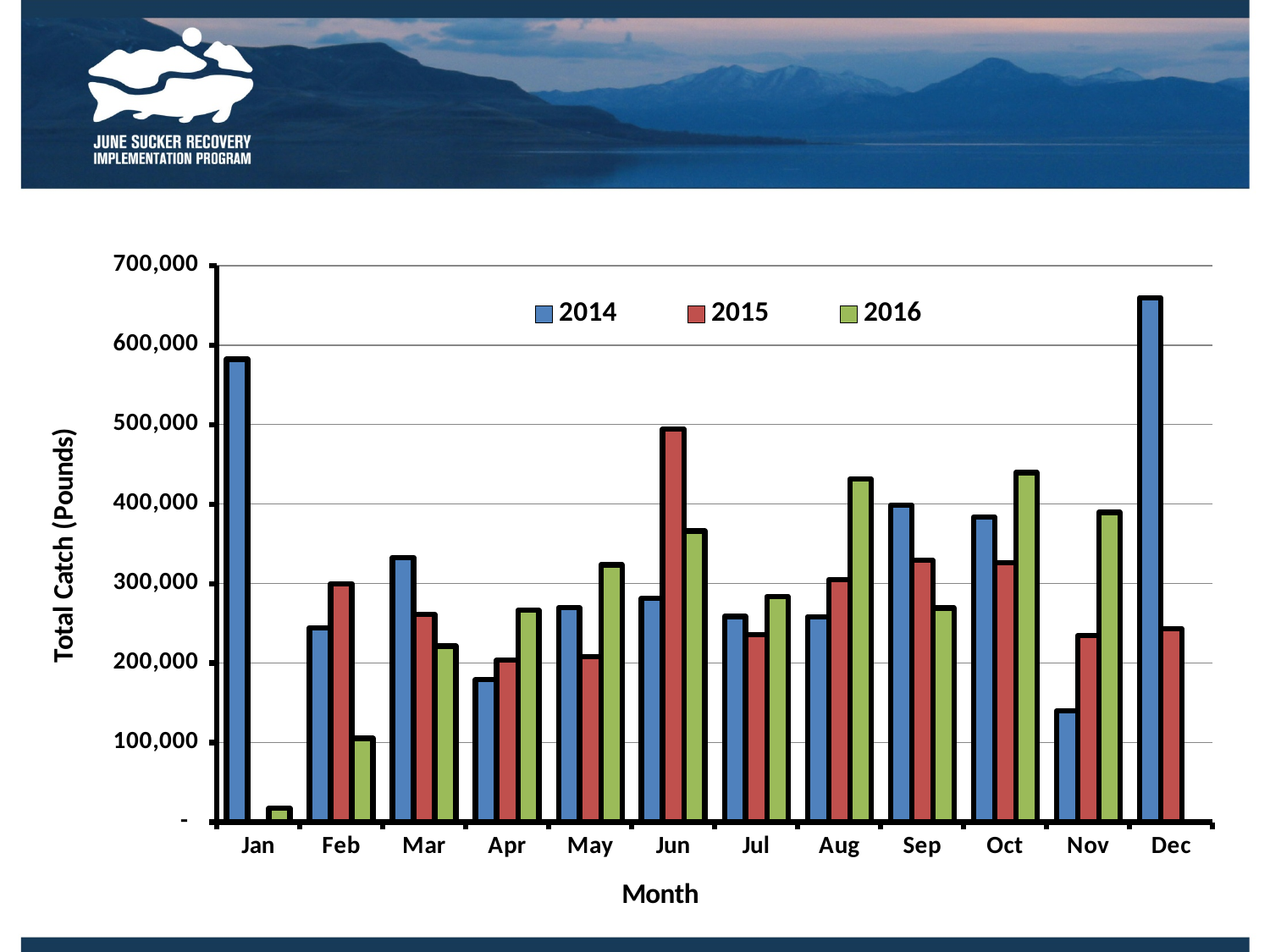
Is the 2016 total catch for Feb greater or less than 200,000? less How many series does the legend list? 3 In which month is the 2014 total catch highest? Dec In Nov, which year has the larger total catch, 2014 or 2016? 2016 Is the 2014 total catch for Jan greater or less than 500,000? greater How many months are shown along the x axis? 12 In which month is the 2015 total catch highest? Jun What is the title of the y axis? Total Catch (Pounds) What kind of chart is shown on the slide? bar chart In which month is the 2014 total catch lowest? Nov Is the 2015 total catch for Jun greater or less than 400,000? greater In which month is the 2016 total catch lowest? Jan